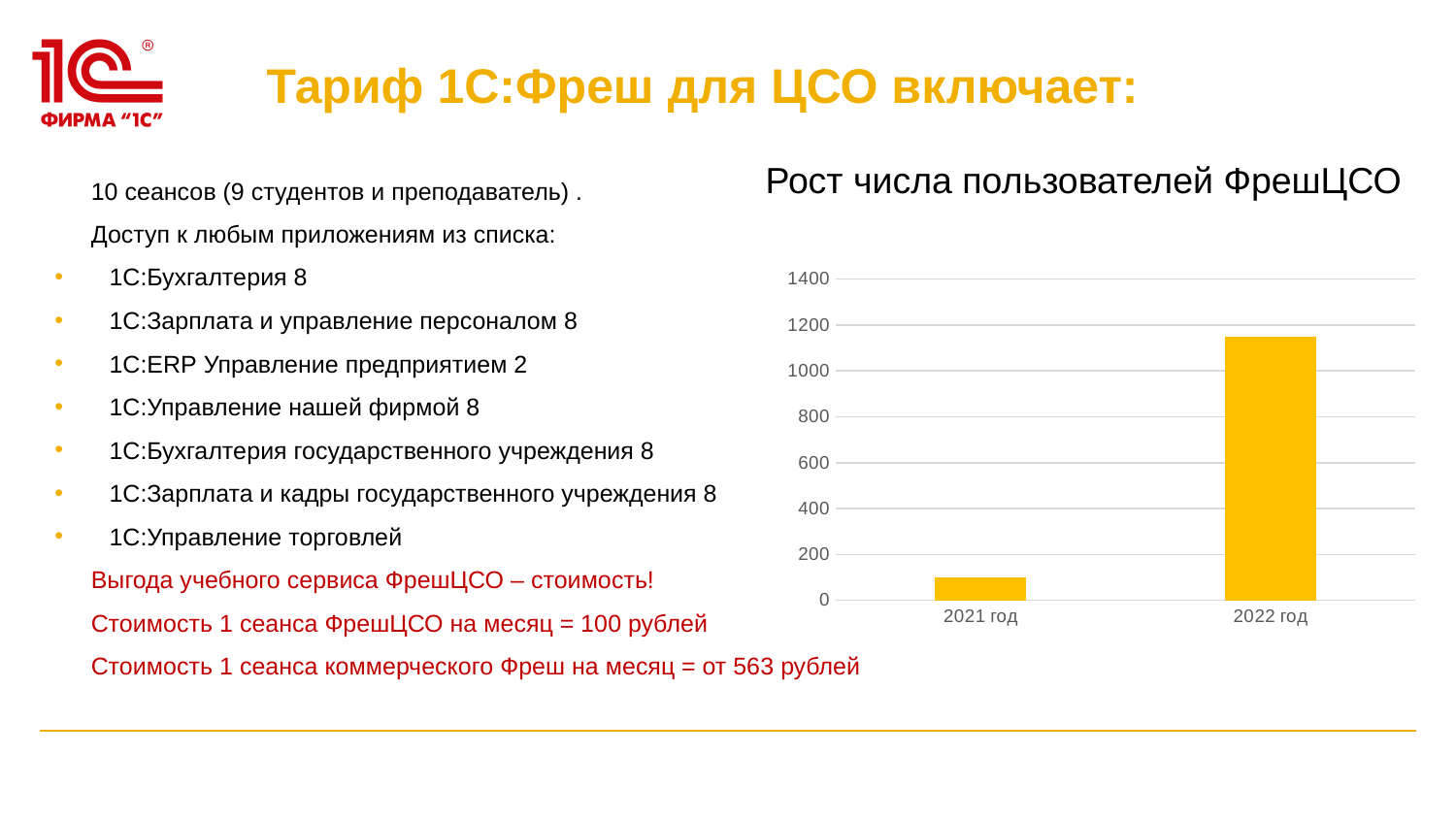
Which category has the highest value in the chart? 2022 год Which is larger, the value for 2021 год or the value for 2022 год? 2022 год Is the value for 2022 год greater or less than 1000? greater What is the highest value shown on the vertical axis of the chart? 1400 Is the value for 2022 год greater or less than 1200? less What is the title of the chart? Рост числа пользователей ФрешЦСО Which category has the lowest value in the chart? 2021 год What kind of chart is shown on the slide? bar chart Do the values rise or fall from 2021 год to 2022 год? rise How many categories are plotted on the x axis of the chart? 2 Is the value for 2021 год greater or less than 200? less